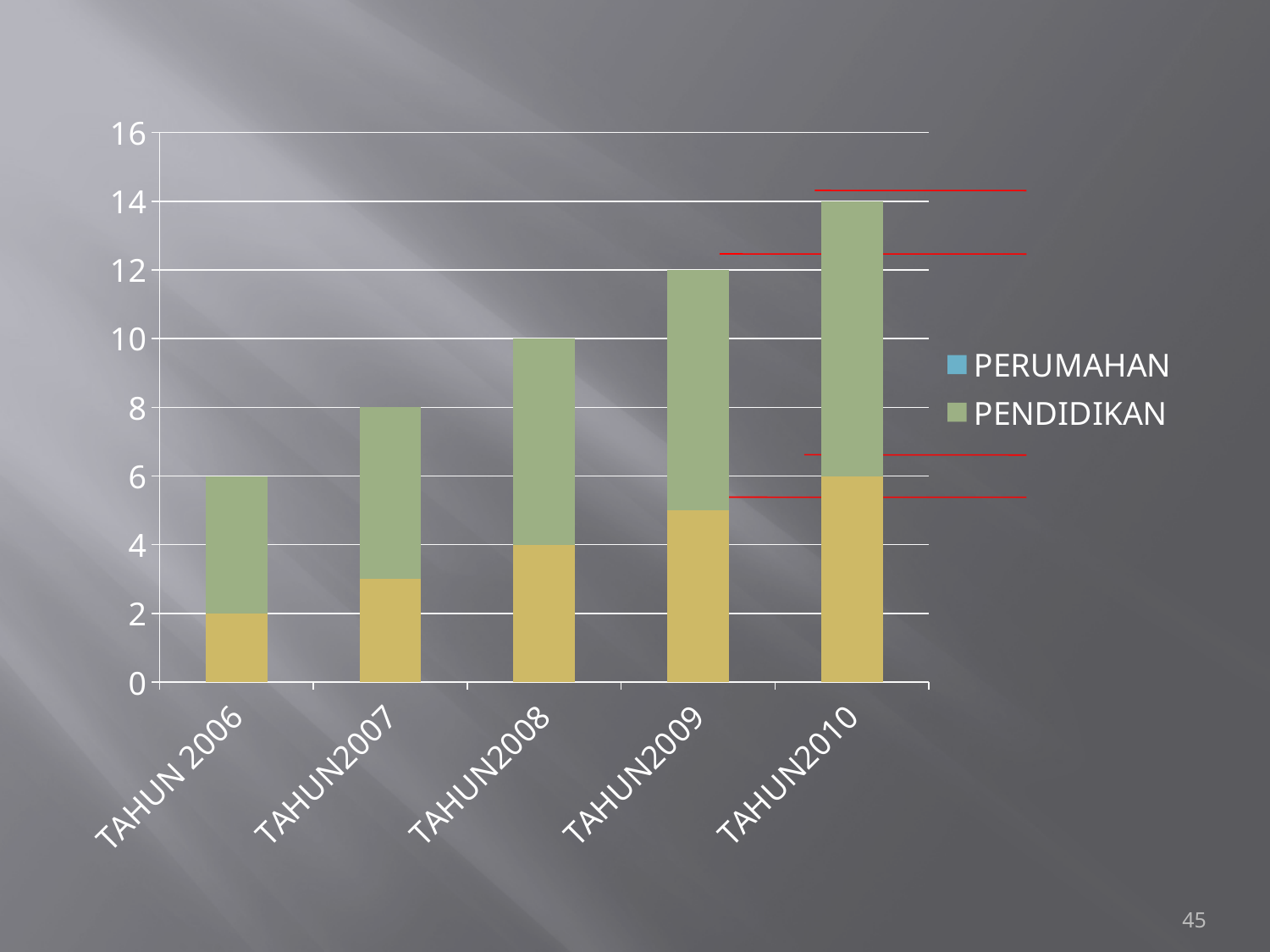
What is the difference between the total bar for TAHUN2010 and the total bar for TAHUN 2006? 8 What kind of chart is shown on the slide? Stacked bar chart What is the total height of the stacked bar for TAHUN 2006? 6 Which year has the lowest total stacked bar? TAHUN 2006 How many categories (years) are shown on the x axis? 5 Do the total bar heights rise or fall from TAHUN 2006 to TAHUN2010? Rise What is the total height of the stacked bar for TAHUN2010? 14 Which year has the highest total stacked bar? TAHUN2010 How many series does the legend list? 2